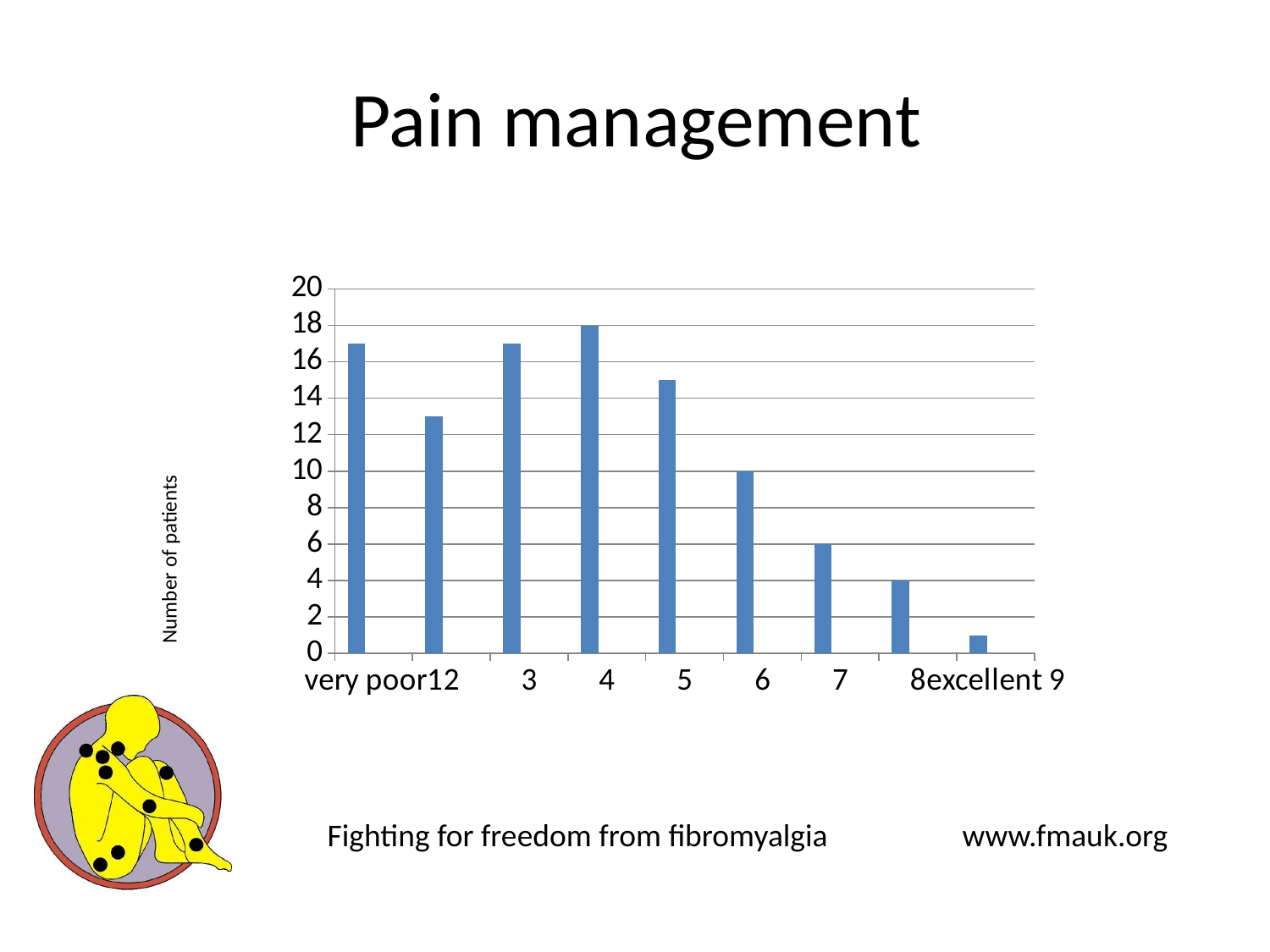
Which rating has the lowest number of patients? excellent 9 What is the number of patients for rating 7? 6 What is the number of patients for rating 4? 18 What is the number of patients for rating 8? 4 Which has more patients, rating 2 or rating 3? 3 What is the difference in number of patients between rating 4 and rating 6? 8 What kind of chart is shown on the slide? bar chart How many categories are shown on the x axis of the chart? 9 What is the label on the vertical axis of the chart? Number of patients What is the number of patients for rating 6? 10 Which rating has the highest number of patients? 4 Is the value for very poor 1 greater or less than 16? greater